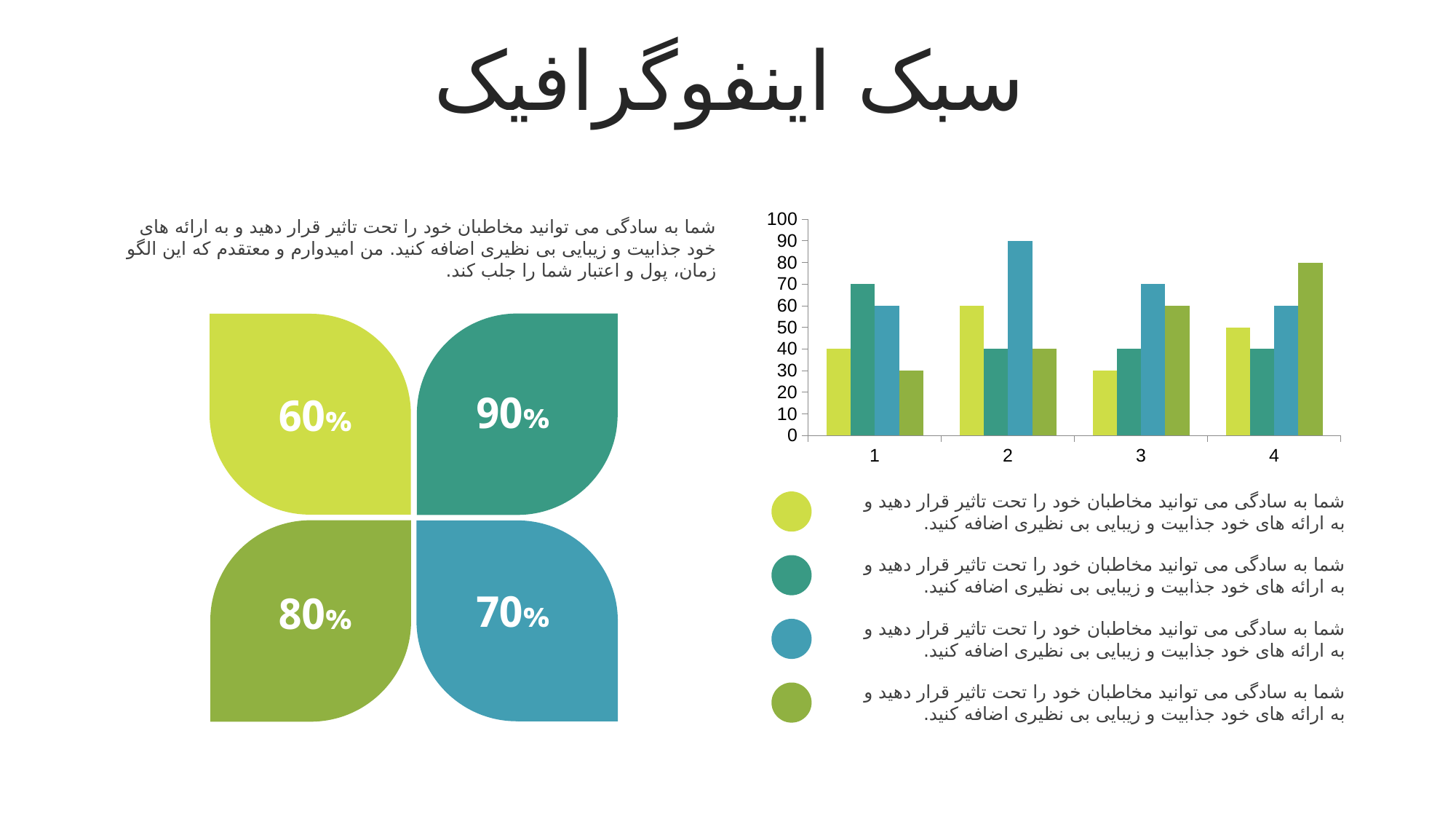
What is the maximum value shown on the y axis of the bar chart? 100 In the bar chart, for which category is the light green bar the lowest? 3 In the bar chart, which category has the tallest bar overall? 2 In the bar chart, which is larger for category 4: the light green bar or the teal bar? the light green bar What kind of chart is shown on the right of the slide? bar chart In the bar chart, what is the value of the light green bar for category 3? 30 In the bar chart, what is the value of the olive green bar for category 4? 80 How many categories are shown on the x axis of the bar chart? 4 In the bar chart, what is the value of the teal bar for category 1? 70 In the bar chart, what is the value of the blue bar for category 2? 90 In the bar chart, what is the difference between the blue bar and the olive green bar for category 1? 30 How many bars are plotted for each category in the bar chart? 4